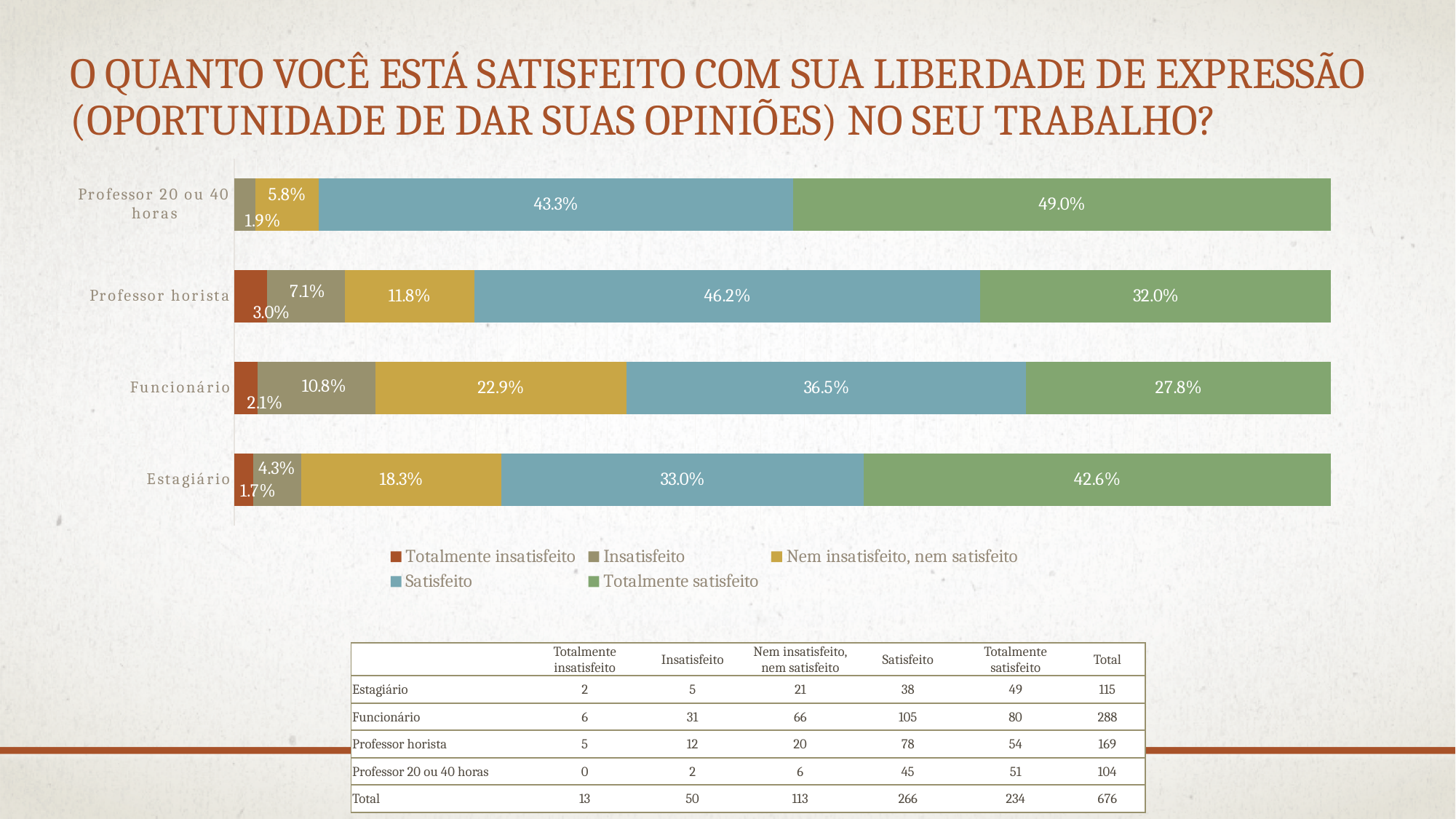
Which category has the highest value for Totalmente satisfeito? Professor 20 ou 40 horas What is the value for Totalmente satisfeito in the Funcionário bar? 27.8% How many series does the legend list? 5 What is the difference between the Totalmente satisfeito values for Professor 20 ou 40 horas and Professor horista? 17.0 percentage points Which category has the highest value for Nem insatisfeito, nem satisfeito? Funcionário Which is larger: the Nem insatisfeito, nem satisfeito value for Funcionário or for Estagiário? Funcionário What kind of chart is shown on the slide? Stacked bar chart What is the value for Satisfeito in the Professor horista bar? 46.2% How many categories are shown in the chart? 4 What is the value for Nem insatisfeito, nem satisfeito in the Estagiário bar? 18.3% Which category has the lowest value for Satisfeito? Estagiário What is the value for Insatisfeito in the Funcionário bar? 10.8%